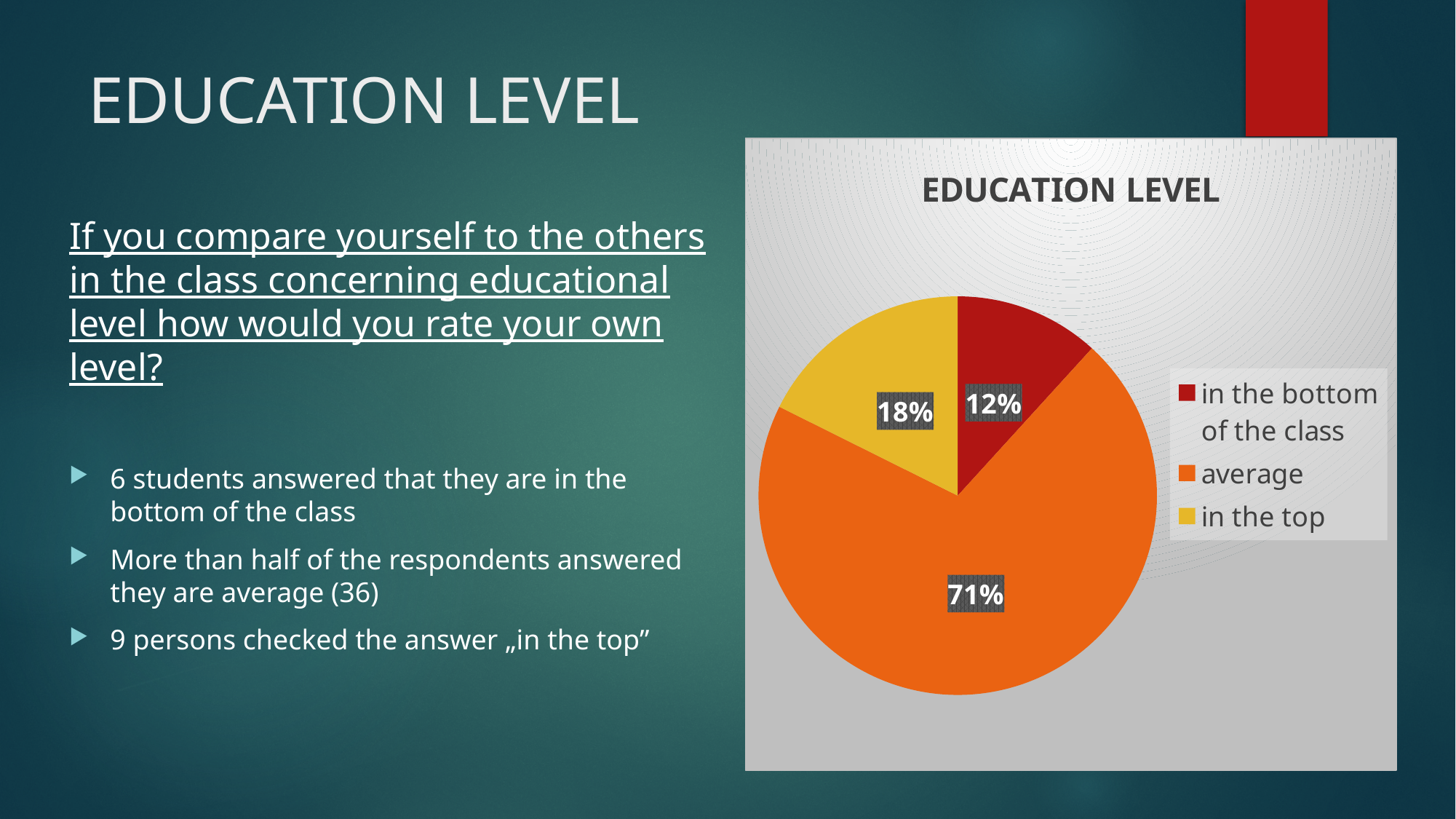
What type of chart is shown on the slide? pie chart Which category has the largest share of the pie? average How many categories does the pie chart show? 3 What is the difference in percentage points between the 'average' slice and the 'in the top' slice? 53 Which is larger, the share for 'in the top' or the share for 'in the bottom of the class'? in the top Which category has the smallest share of the pie? in the bottom of the class What colour is the 'average' slice in the pie chart? orange What percentage of respondents said they are in the top? 18% What percentage of respondents rated themselves as average? 71% What is the chart's title? EDUCATION LEVEL What is the difference in percentage points between the 'in the top' slice and the 'in the bottom of the class' slice? 6 What percentage of respondents said they are in the bottom of the class? 12%